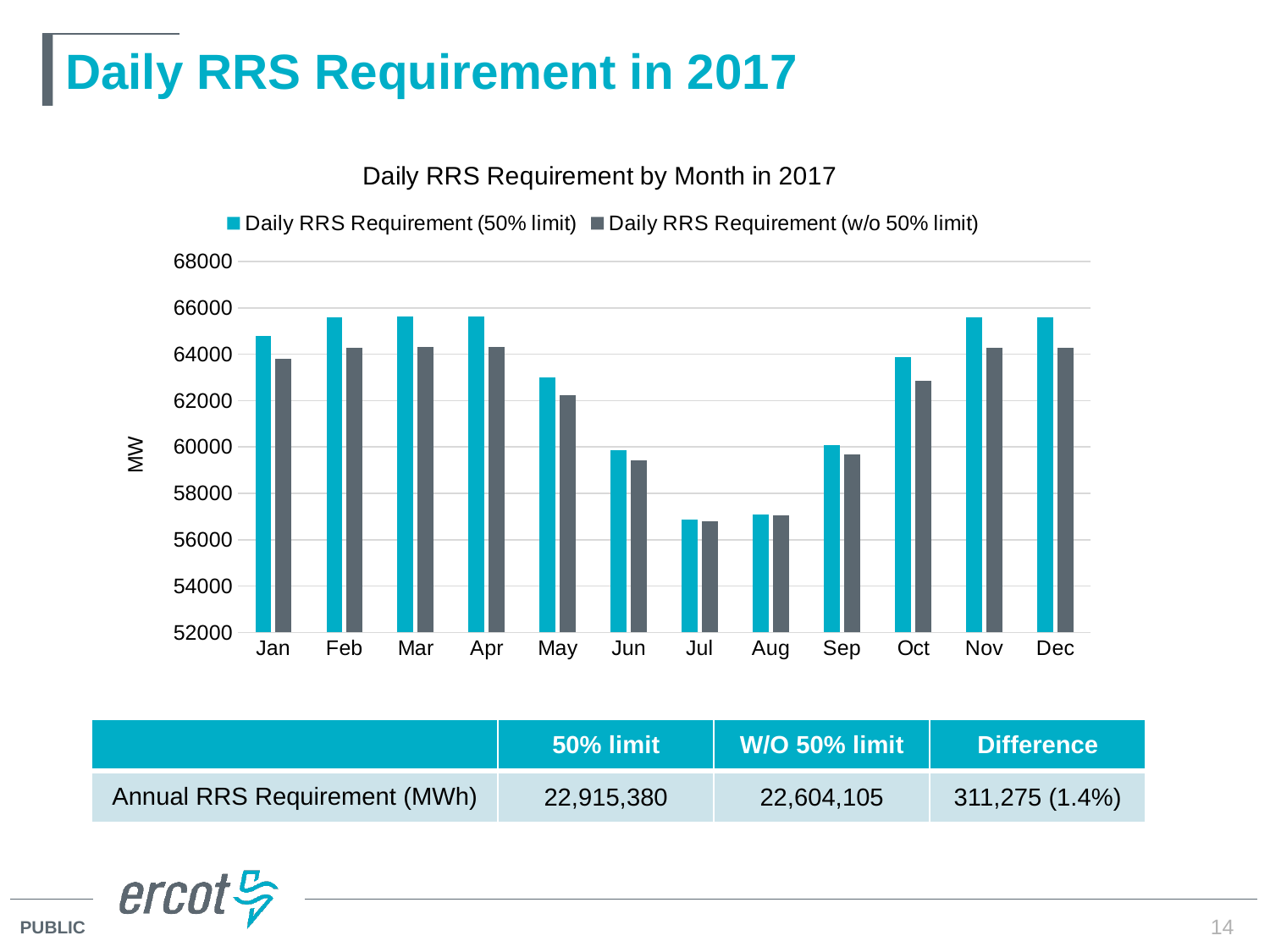
What is the title of the chart? Daily RRS Requirement by Month in 2017 Is the value for Jul in the Daily RRS Requirement (w/o 50% limit) series greater or less than 58000? less What is the label on the vertical axis of the chart? MW How many months are shown on the x axis of the chart? 12 How many series does the chart legend list? 2 Is the value for May in the Daily RRS Requirement (50% limit) series greater or less than 62000? greater For Oct, which series has the larger value: Daily RRS Requirement (50% limit) or Daily RRS Requirement (w/o 50% limit)? Daily RRS Requirement (50% limit) For Jan, which series has the larger value: Daily RRS Requirement (50% limit) or Daily RRS Requirement (w/o 50% limit)? Daily RRS Requirement (50% limit) Is the value for Jan in the Daily RRS Requirement (50% limit) series greater or less than 64000? greater What kind of chart is shown on the slide? bar chart Do the Daily RRS Requirement (50% limit) values rise or fall from Apr to Jul? fall